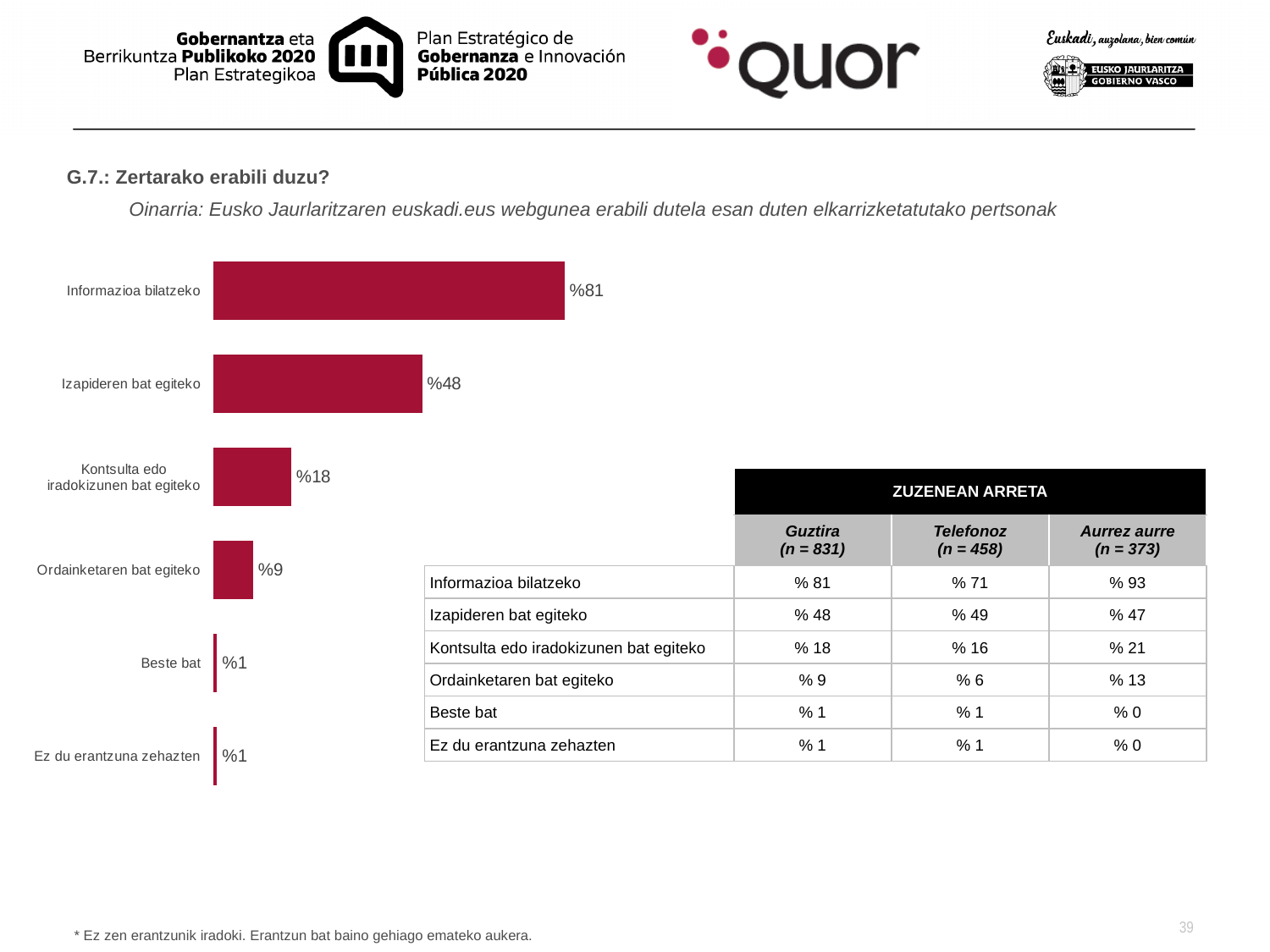
What is the value for Informazioa bilatzeko in the bar chart? %81 What is the value for Izapideren bat egiteko in the bar chart? %48 What colour are the bars in the chart? Dark red What is the value for Ordainketaren bat egiteko in the bar chart? %9 What is the difference between the values for Kontsulta edo iradokizunen bat egiteko and Ordainketaren bat egiteko in the bar chart? %9 How many categories are shown in the bar chart? 6 What is the value for Beste bat in the bar chart? %1 What is the value for Kontsulta edo iradokizunen bat egiteko in the bar chart? %18 What kind of chart is shown on the slide? Bar chart Which category has the highest value in the bar chart? Informazioa bilatzeko Which is larger in the bar chart, the value for Izapideren bat egiteko or the value for Kontsulta edo iradokizunen bat egiteko? Izapideren bat egiteko What is the difference between the values for Informazioa bilatzeko and Izapideren bat egiteko in the bar chart? %33